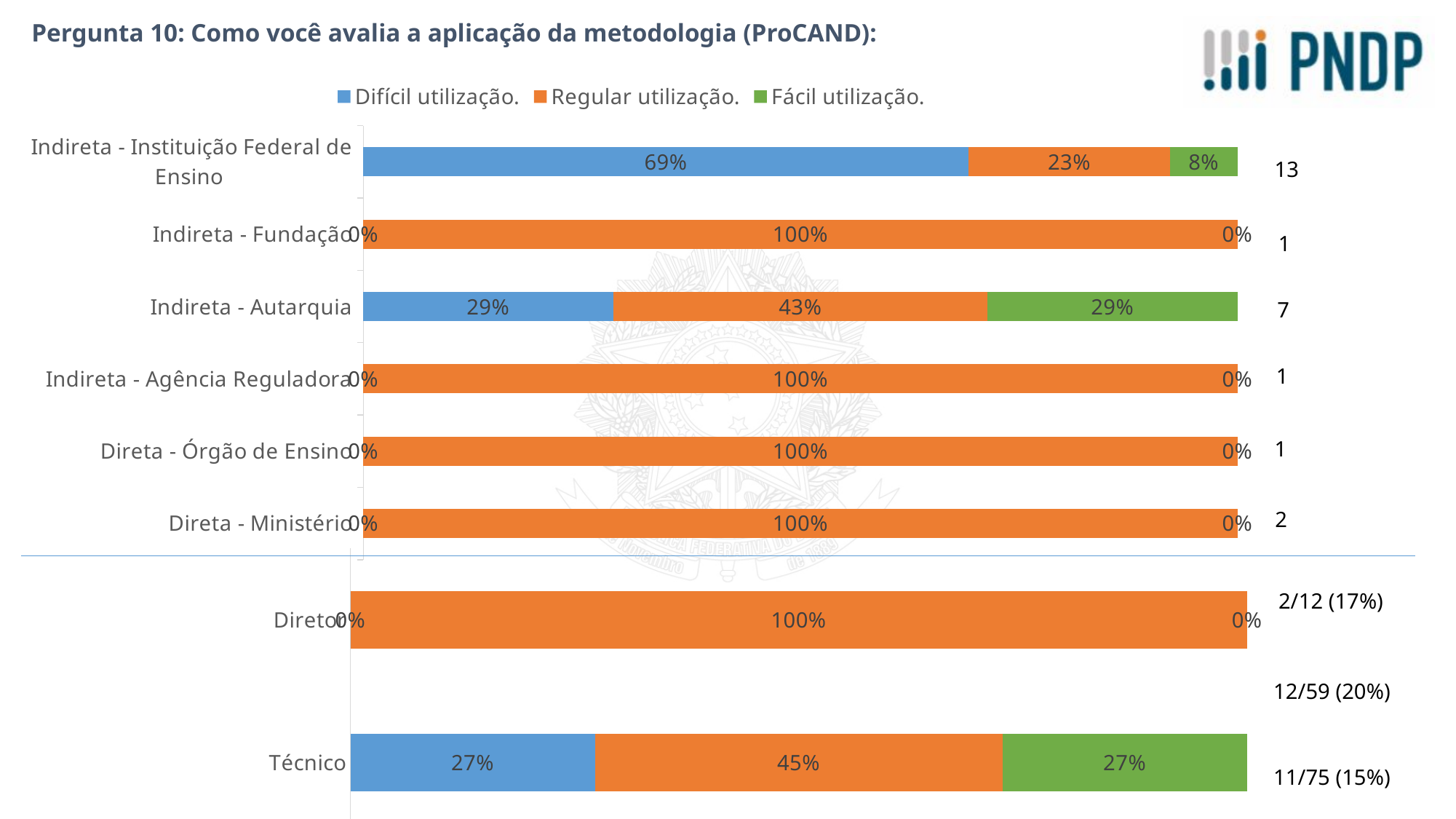
In the top chart, which is larger for 'Indireta - Autarquia': 'Regular utilização.' or 'Fácil utilização.'? Regular utilização. In the top chart, what is the 'Regular utilização.' value for 'Indireta - Fundação'? 100% In the top chart, which category has the highest 'Difícil utilização.' percentage? Indireta - Instituição Federal de Ensino How many categories are shown in the top chart? 6 In the top chart, what number is printed to the right of the 'Indireta - Autarquia' bar? 7 In the top chart, what percentage of 'Indireta - Instituição Federal de Ensino' respondents answered 'Difícil utilização.'? 69% In the bottom chart, what is the 'Difícil utilização.' value for 'Diretor'? 0% How many series does the legend list? 3 In the top chart, what is the 'Fácil utilização.' value for 'Indireta - Autarquia'? 29% In the bottom chart, what is the 'Regular utilização.' value for 'Técnico'? 45% What kind of chart is the top chart? Stacked bar chart In the top chart, what is the difference between the 'Difícil utilização.' and 'Regular utilização.' values for 'Indireta - Instituição Federal de Ensino'? 46%